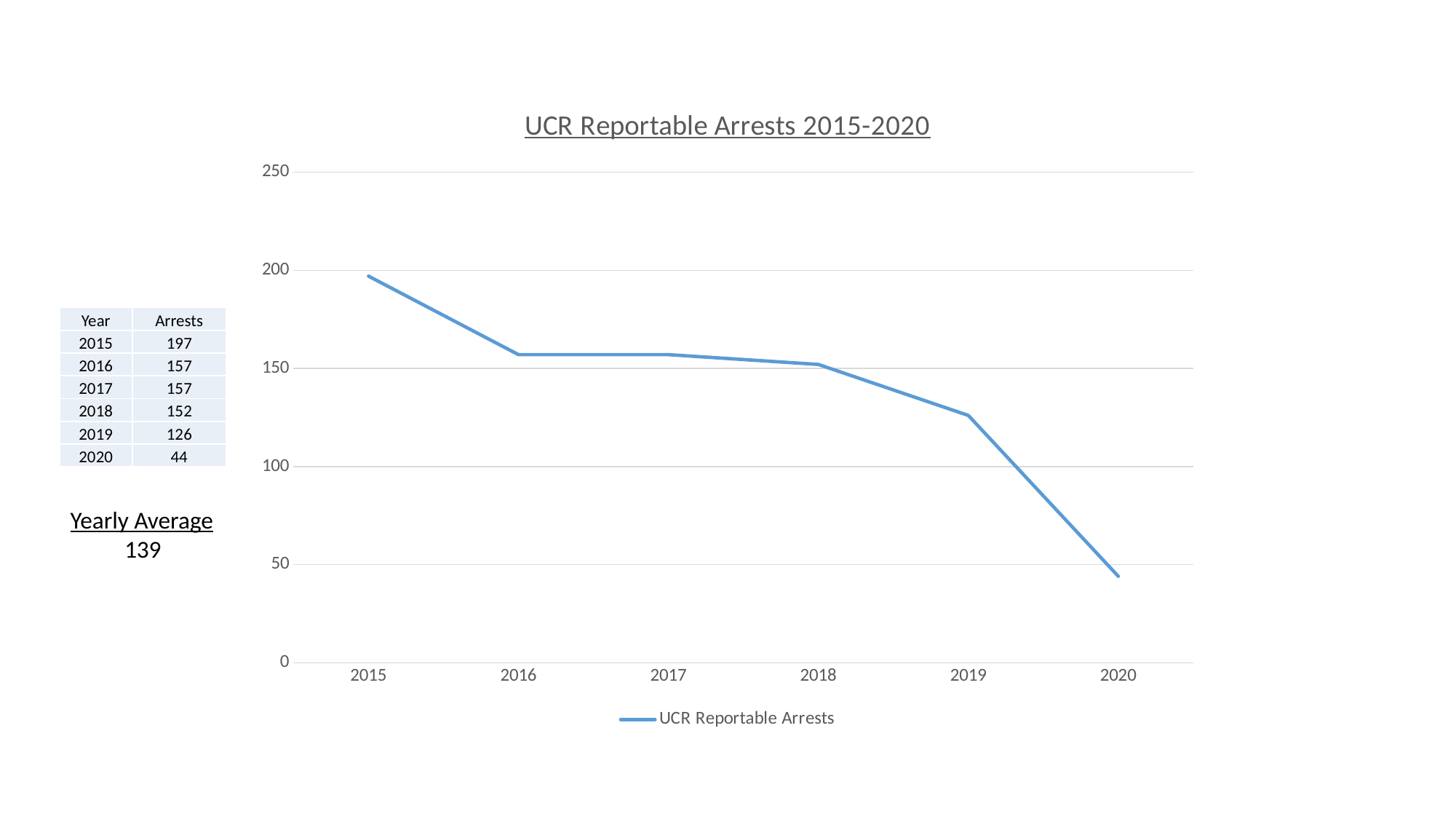
Which year has the lowest number of UCR Reportable Arrests? 2020 What kind of chart is shown on the slide? line chart What is the number of UCR Reportable Arrests in 2015? 197 What is the difference in UCR Reportable Arrests between 2019 and 2020? 82 Which year has the highest number of UCR Reportable Arrests? 2015 Which year has more UCR Reportable Arrests, 2018 or 2019? 2018 How many series does the legend list? 1 Is the value for 2019 greater or less than 150? less How many years are plotted on the x axis? 6 What is the number of UCR Reportable Arrests in 2020? 44 What is the title of the chart? UCR Reportable Arrests 2015-2020 Do the UCR Reportable Arrests rise or fall from 2015 to 2020? fall